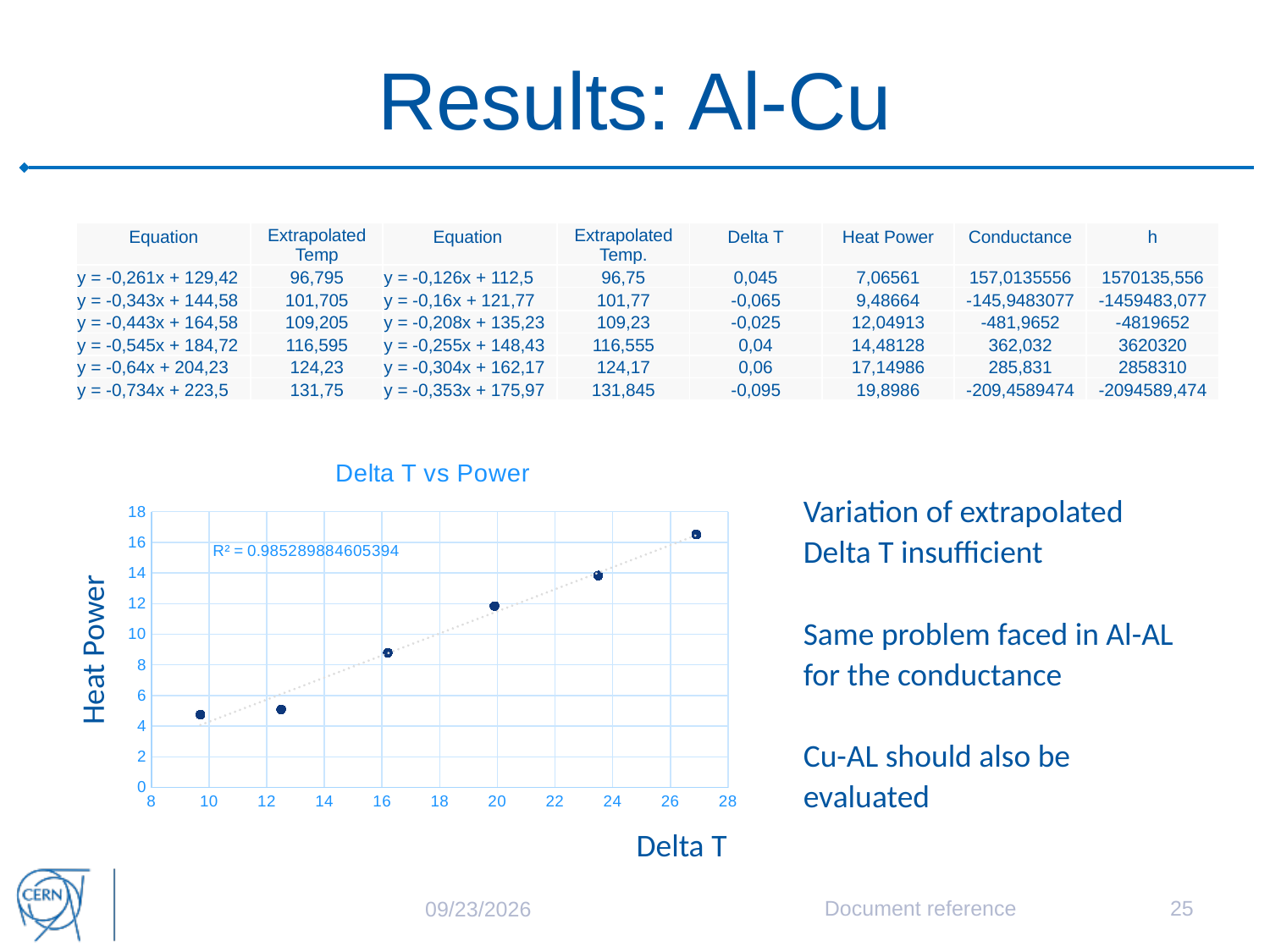
In the Delta T vs Power chart, is the Heat Power of the point near Delta T = 20 greater or less than 10? greater What R² value is printed on the Delta T vs Power chart? R² = 0.985289884605394 What is the highest value shown on the y axis of the Delta T vs Power chart? 18 In the Delta T vs Power chart, which has the higher Heat Power: the point near Delta T = 12.5 or the point near Delta T = 23.5? the point near Delta T = 23.5 In the Delta T vs Power chart, is the Heat Power of the rightmost point (near Delta T = 27) greater or less than 14? greater What is the title of the chart on the slide? Delta T vs Power Does Heat Power rise or fall as Delta T increases in the chart? rise What is the label of the y axis of the chart? Heat Power In the Delta T vs Power chart, is the Heat Power of the point near Delta T = 16 greater or less than 10? less What type of chart is shown on the slide? scatter chart How many data points are plotted in the Delta T vs Power chart? 6